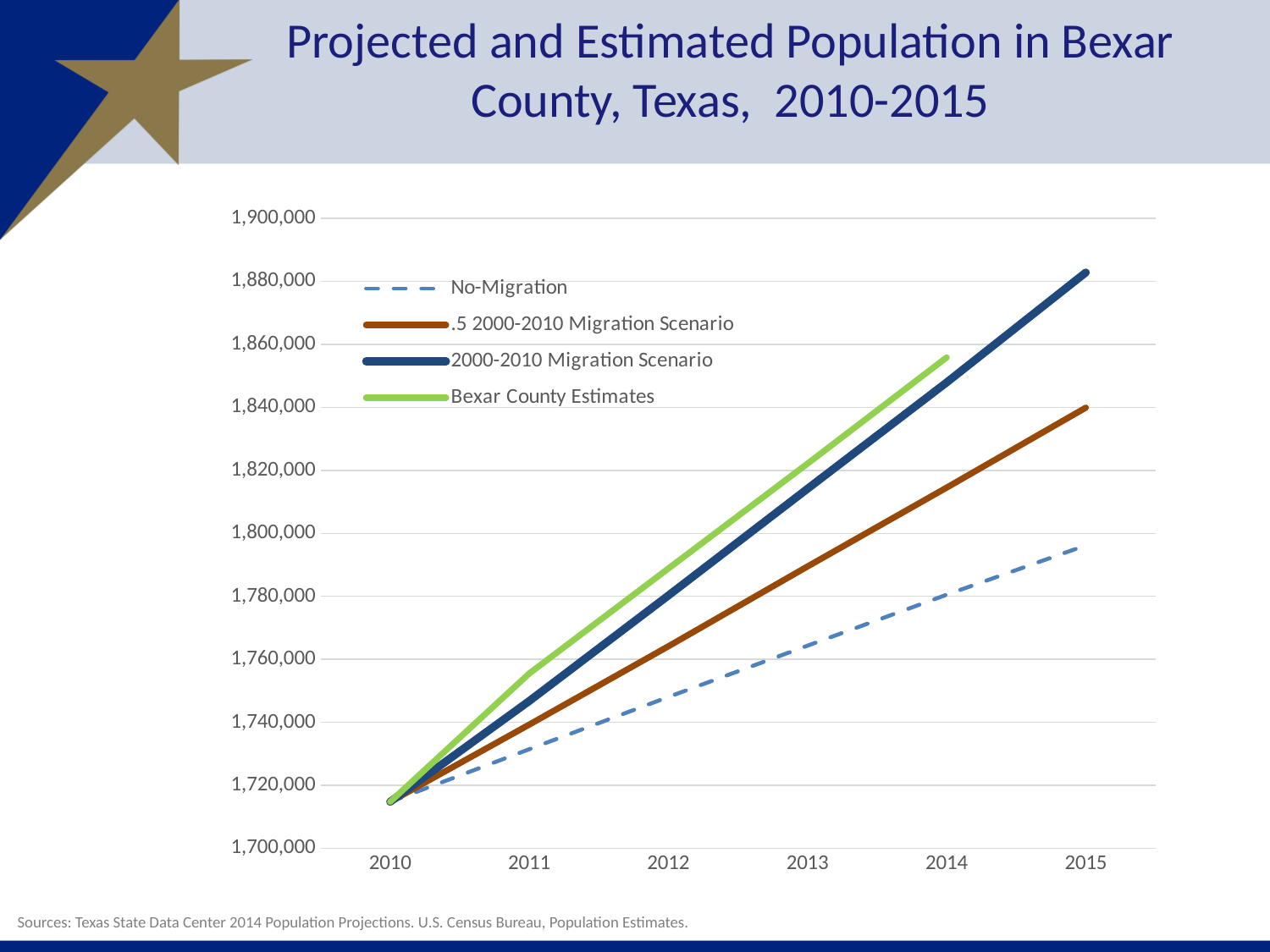
Which series has the lowest value in 2015? No-Migration Do the values for the No-Migration series rise or fall from 2010 to 2015? rise Is the value for No-Migration in 2015 greater or less than 1,800,000? less Is the value for Bexar County Estimates in 2014 greater or less than 1,860,000? less How many years are shown on the x axis? 6 Which series is drawn with a dashed line? No-Migration How many series does the legend list? 4 What is the title of the chart? Projected and Estimated Population in Bexar County, Texas, 2010-2015 Which series has the highest value in 2015? 2000-2010 Migration Scenario What kind of chart is shown on the slide? line chart Is the value for the 2000-2010 Migration Scenario in 2015 greater or less than 1,880,000? greater In 2013, which is larger: the .5 2000-2010 Migration Scenario or the No-Migration series? .5 2000-2010 Migration Scenario